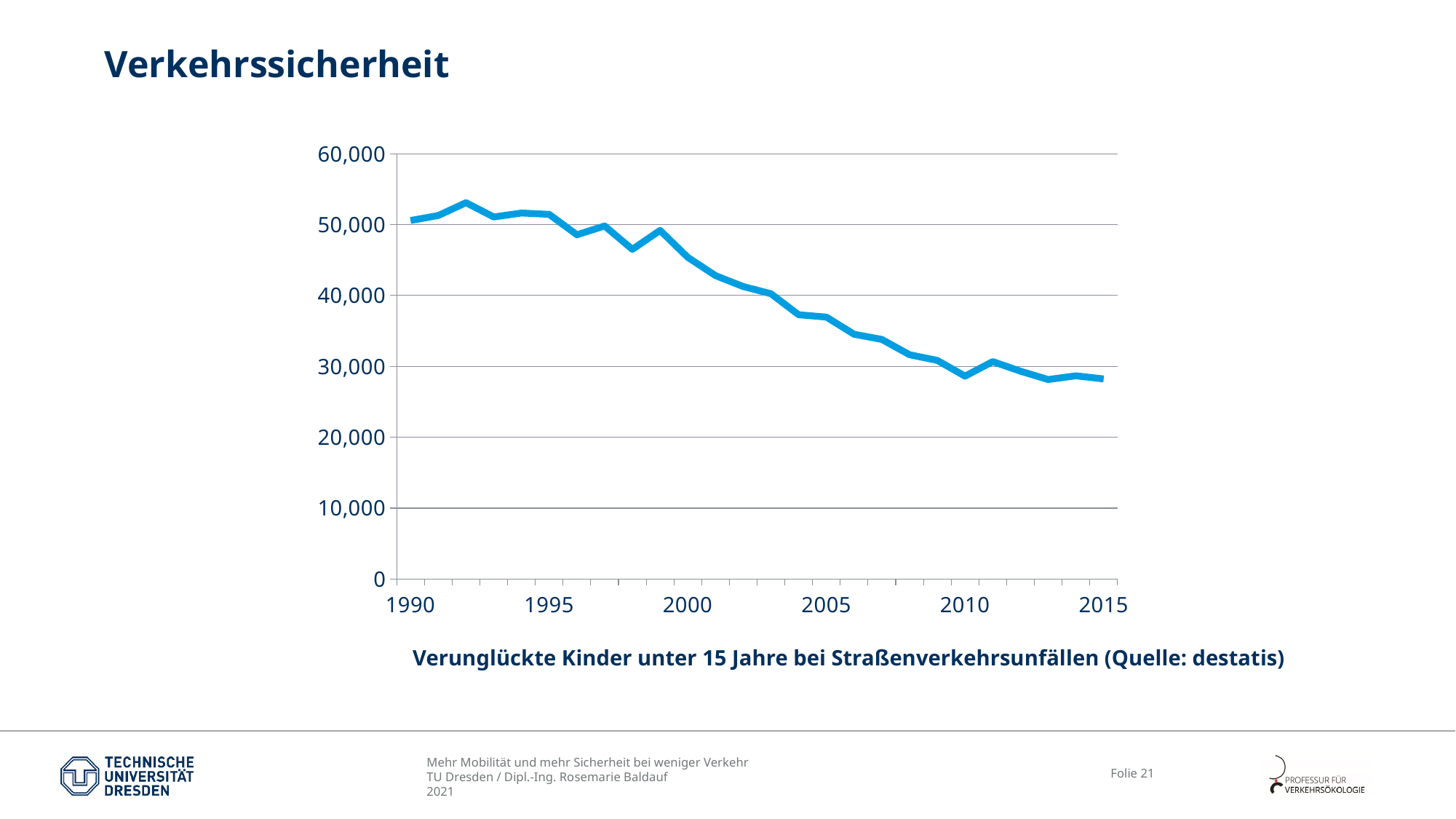
Is the value for 2015 greater or less than 30,000? less In which year is the value highest? 1992 Is the value for 1998 greater or less than 50,000? less Do the values generally rise or fall from 1990 to 2015? fall Which year has the larger value, 2000 or 2005? 2000 What is the caption below the chart? Verunglückte Kinder unter 15 Jahre bei Straßenverkehrsunfällen (Quelle: destatis) Is the value for 2005 greater or less than 40,000? less Which year has the larger value, 1990 or 2015? 1990 What kind of chart is shown on the slide? line chart